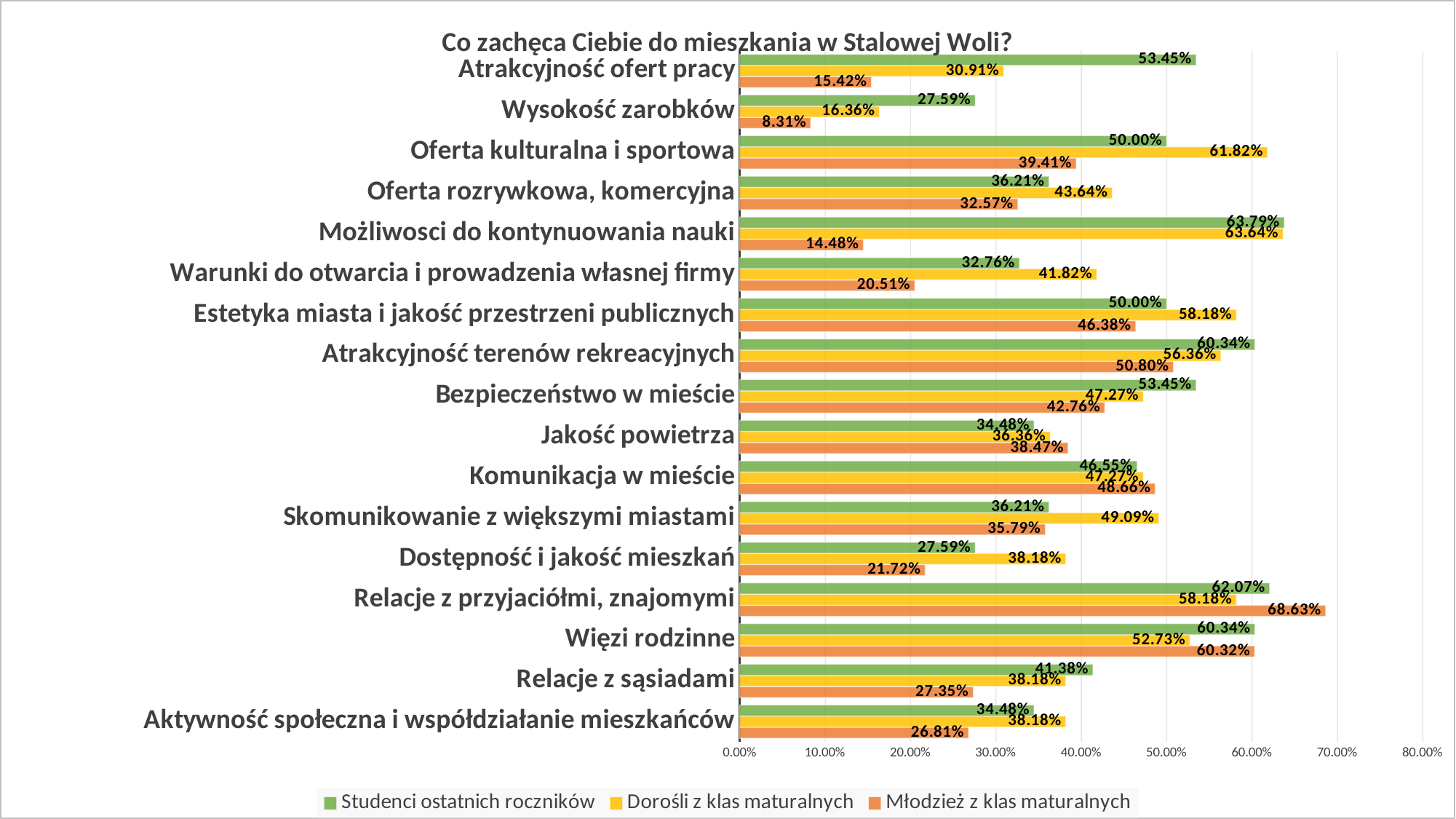
Which category has the lowest value for Młodzież z klas maturalnych? Wysokość zarobków Which category has the highest value for Młodzież z klas maturalnych? Relacje z przyjaciółmi, znajomymi What kind of chart is shown on the slide? Bar chart What is the value for Dorośli z klas maturalnych for Oferta kulturalna i sportowa? 61.82% How many series does the legend list? 3 What is the value for Młodzież z klas maturalnych for Wysokość zarobków? 8.31% What is the value for Studenci ostatnich roczników for Atrakcyjność ofert pracy? 53.45% What is the difference between the Studenci ostatnich roczników and Młodzież z klas maturalnych values for Atrakcyjność ofert pracy? 38.03 percentage points Is the value for Młodzież z klas maturalnych for Możliwosci do kontynuowania nauki greater or less than 20.00%? less For Skomunikowanie z większymi miastami, which series has the larger value: Dorośli z klas maturalnych or Studenci ostatnich roczników? Dorośli z klas maturalnych Which category has the highest value for Studenci ostatnich roczników? Możliwosci do kontynuowania nauki How many categories are shown on the chart? 17